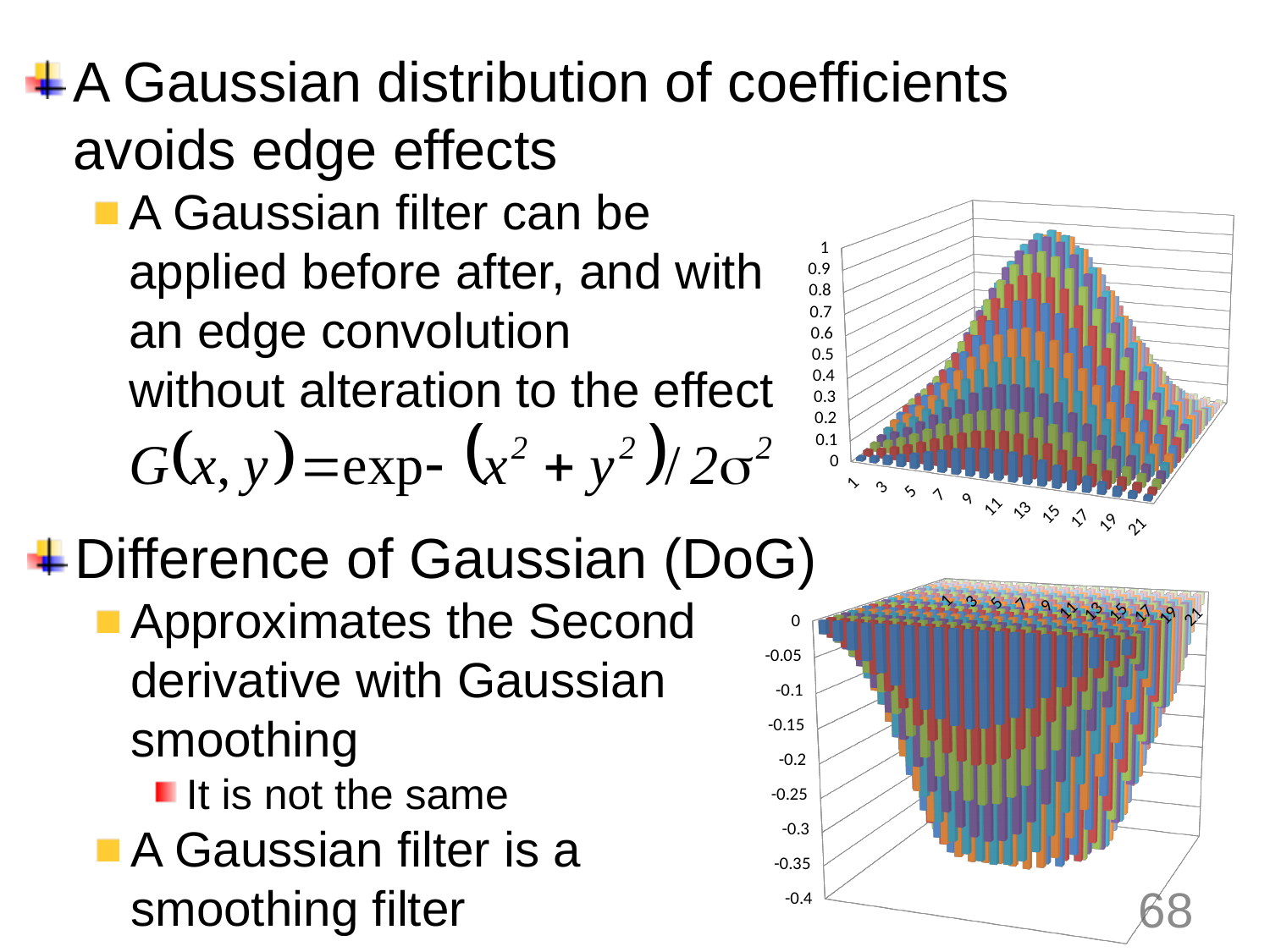
In the bottom chart, is the lowest bar greater or less than -0.2? less In the bottom chart, what is the lowest value shown on the vertical axis? -0.4 In the top chart, is the bar at category 1 greater or less than 0.5? less What kind of chart is the bottom chart on the right of the slide? 3D bar chart In the top chart, what is the highest value shown on the vertical axis? 1 In the top chart, is the tallest bar greater or less than 0.5? greater In the top chart, do the bar heights rise or fall from category 1 toward the middle categories? rise In the top chart, what is the last category label shown on the horizontal axis? 21 What kind of chart is the top chart on the right of the slide? 3D bar chart